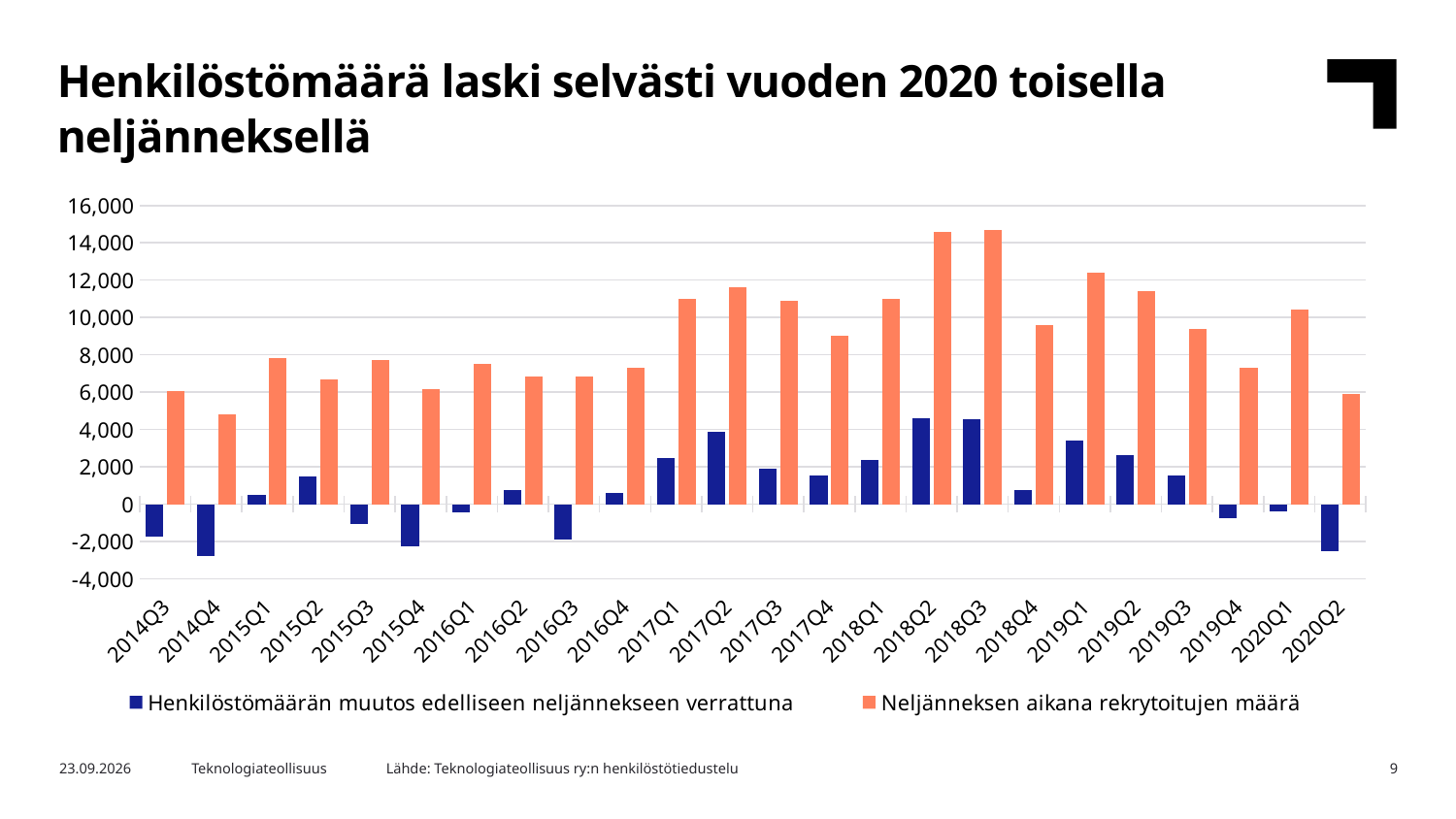
Which quarter has the lowest value for Neljänneksen aikana rekrytoitujen määrä? 2014Q4 How many series does the legend list? 2 Is the value for Neljänneksen aikana rekrytoitujen määrä in 2016Q1 greater or less than 8,000? less Do the values for Neljänneksen aikana rekrytoitujen määrä rise or fall from 2019Q1 to 2019Q4? fall Which is larger for Neljänneksen aikana rekrytoitujen määrä: 2018Q2 or 2017Q1? 2018Q2 Is the value for Neljänneksen aikana rekrytoitujen määrä in 2020Q1 greater or less than 10,000? greater Which is larger for Henkilöstömäärän muutos edelliseen neljännekseen verrattuna: 2017Q2 or 2017Q3? 2017Q2 What kind of chart is shown on the slide? bar chart Is the value for Neljänneksen aikana rekrytoitujen määrä in 2019Q1 greater or less than 12,000? greater How many quarters are shown on the x axis? 24